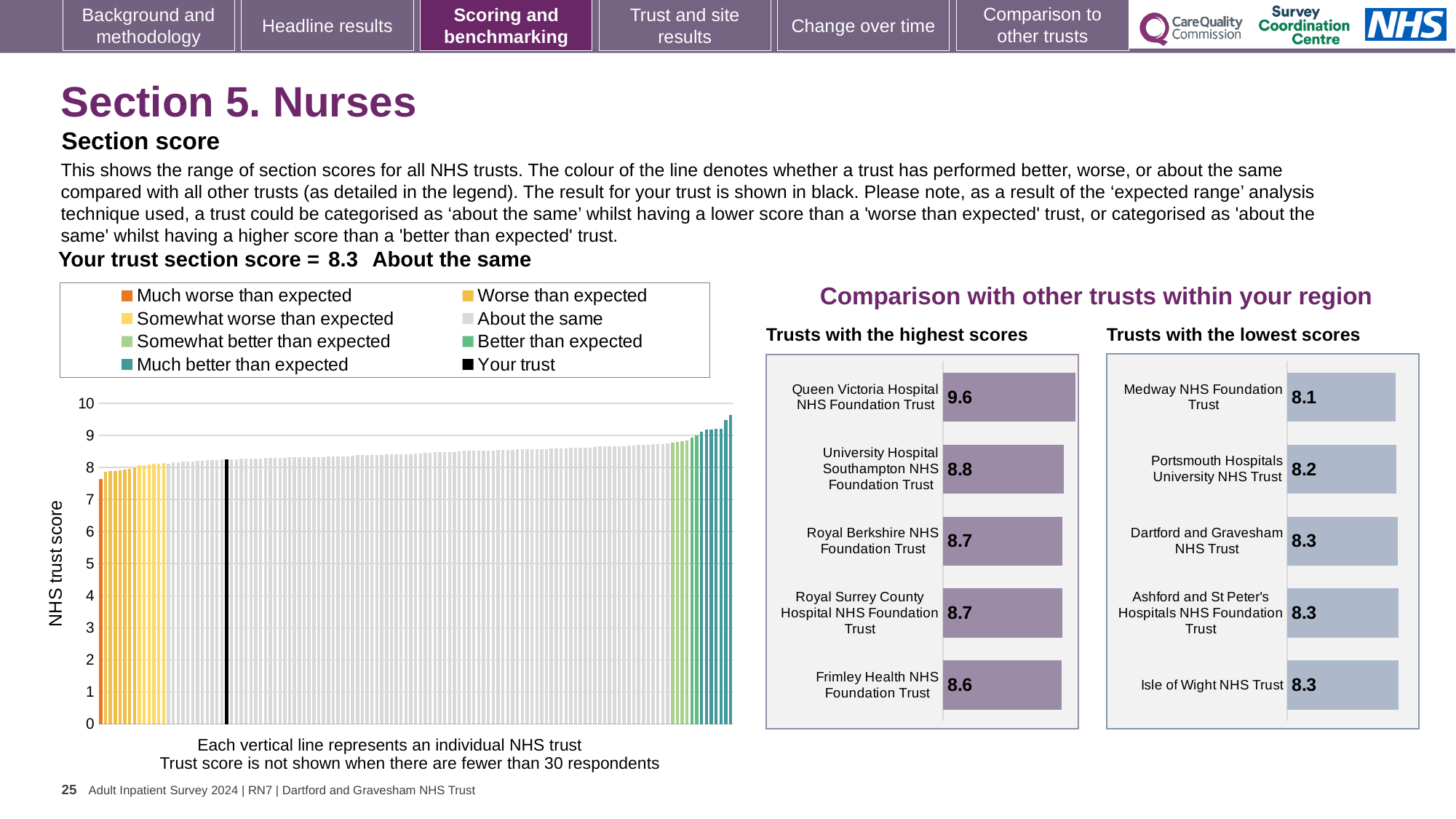
In the 'Trusts with the lowest scores' chart, what is the score for Portsmouth Hospitals University NHS Trust? 8.2 In the 'Trusts with the highest scores' chart, what is the score for Frimley Health NHS Foundation Trust? 8.6 In the 'Trusts with the lowest scores' chart, what is the difference between the scores of Dartford and Gravesham NHS Trust and Medway NHS Foundation Trust? 0.2 In the 'Trusts with the highest scores' chart, what is the difference between the scores of Queen Victoria Hospital NHS Foundation Trust and Frimley Health NHS Foundation Trust? 1.0 In the 'Trusts with the highest scores' chart, what is the score for Queen Victoria Hospital NHS Foundation Trust? 9.6 In the 'Trusts with the lowest scores' chart, which trust has the lowest score? Medway NHS Foundation Trust What is the y-axis title of the large chart on the left? NHS trust score What kind of chart is the large chart on the left showing NHS trust scores? Bar chart In the 'Trusts with the highest scores' chart, which trust has the highest score? Queen Victoria Hospital NHS Foundation Trust How many entries does the legend of the large chart on the left list? 8 In the 'Trusts with the highest scores' chart, which has the higher score: University Hospital Southampton NHS Foundation Trust or Royal Berkshire NHS Foundation Trust? University Hospital Southampton NHS Foundation Trust How many trusts are shown in the 'Trusts with the highest scores' chart? 5